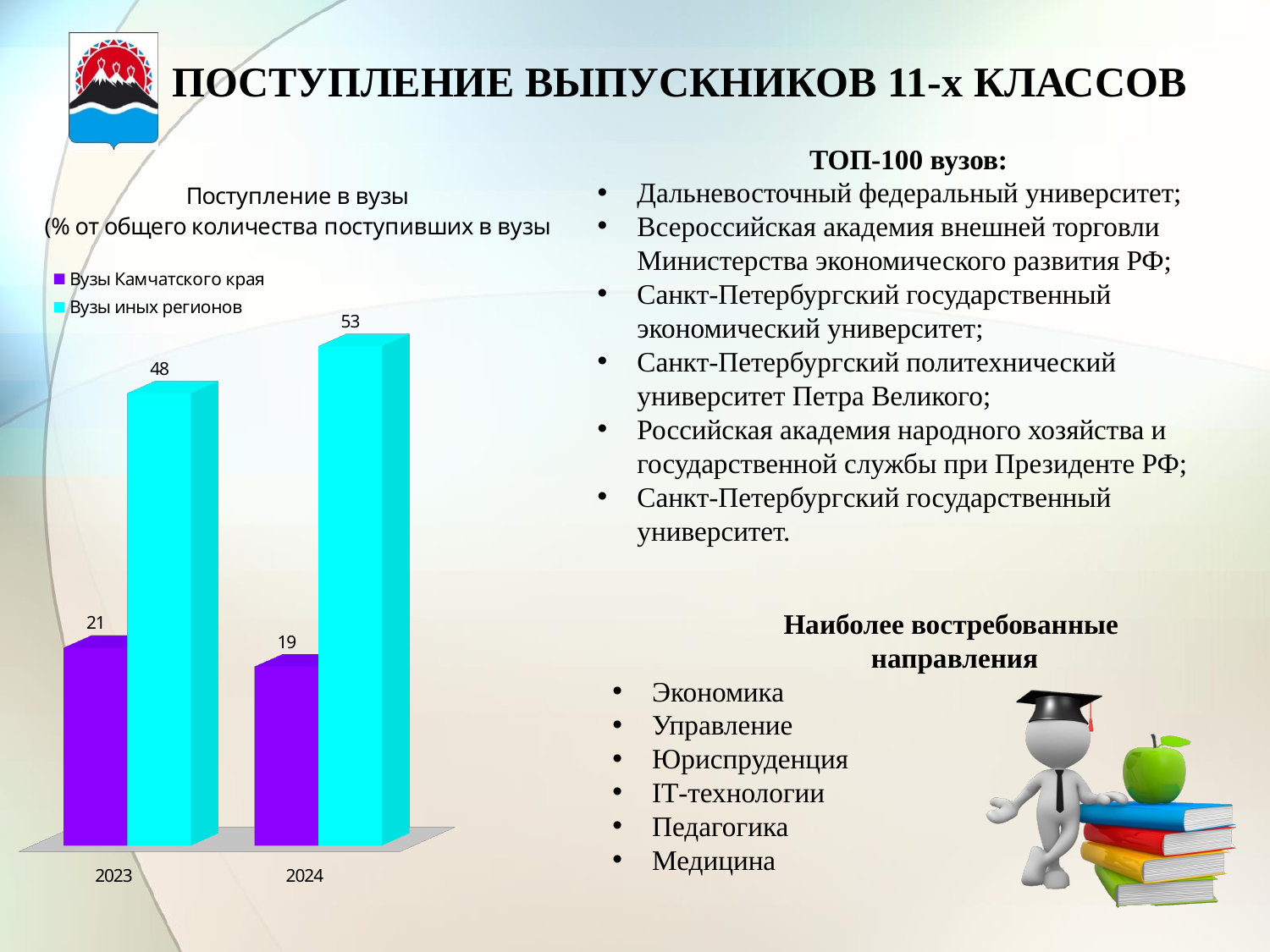
Does the value for Вузы Камчатского края rise or fall from 2023 to 2024? Fall What is the value for Вузы иных регионов in 2023? 48 In which year is the value for Вузы иных регионов highest? 2024 How many years are shown on the x axis? 2 What is the value for Вузы иных регионов in 2024? 53 In which year is the value for Вузы Камчатского края lowest? 2024 What is the difference between Вузы иных регионов and Вузы Камчатского края in 2024? 34 What is the value for Вузы Камчатского края in 2023? 21 How many series does the legend list? 2 Which is larger in 2023: Вузы Камчатского края or Вузы иных регионов? Вузы иных регионов What is the value for Вузы Камчатского края in 2024? 19 What kind of chart is shown on the slide? Bar chart